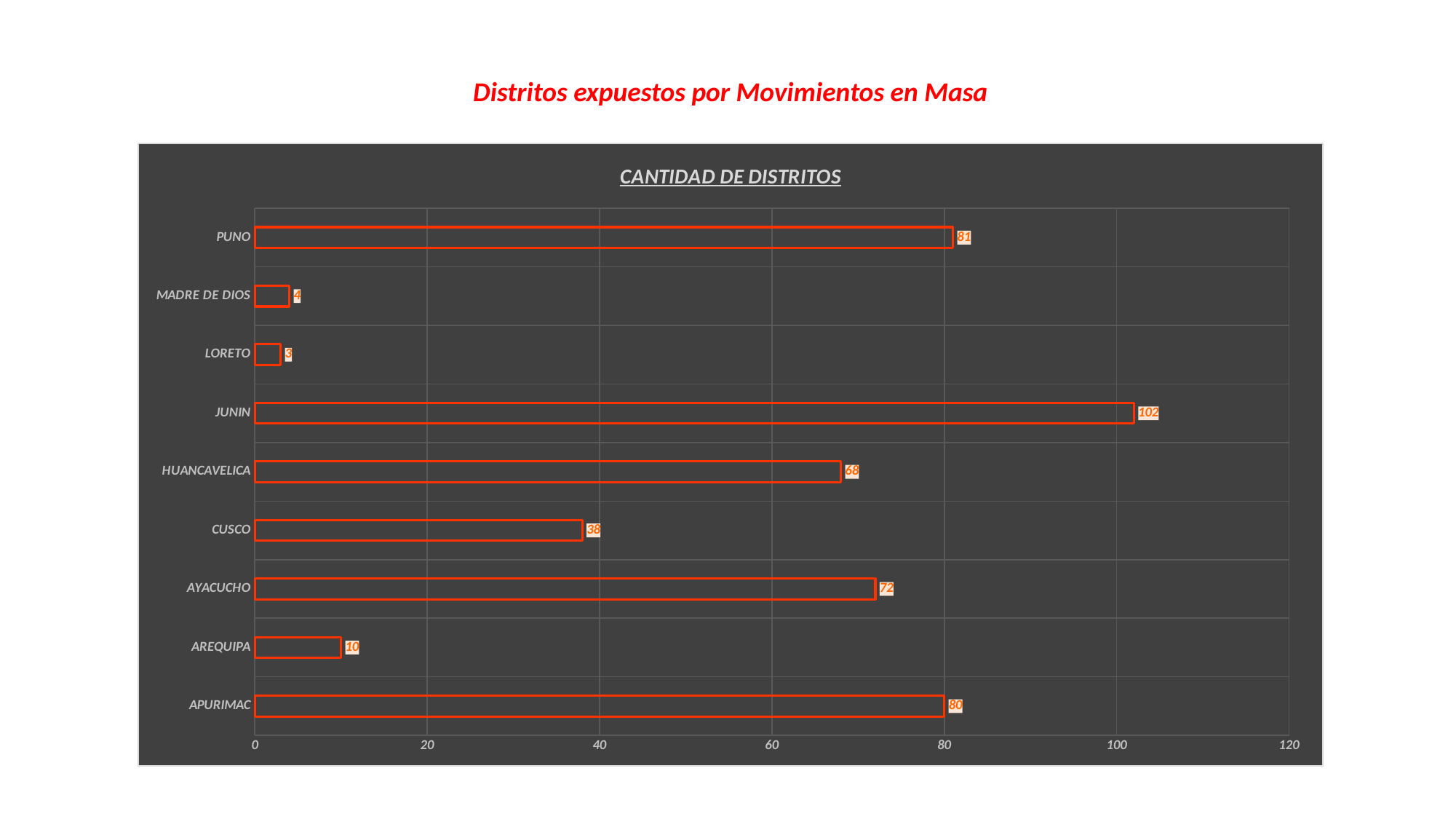
What is the value for JUNIN? 102 What is the difference between the values for PUNO and APURIMAC? 1 Is the value for CUSCO greater or less than 40? less What is the value for AREQUIPA? 10 Which category has the lowest value? LORETO What is the value for HUANCAVELICA? 68 What is the title of the chart? CANTIDAD DE DISTRITOS Which category has the highest value? JUNIN How many categories are shown in the chart? 9 What kind of chart is shown on the slide? bar chart Which is larger, the value for AYACUCHO or the value for HUANCAVELICA? AYACUCHO What is the difference between the values for JUNIN and CUSCO? 64